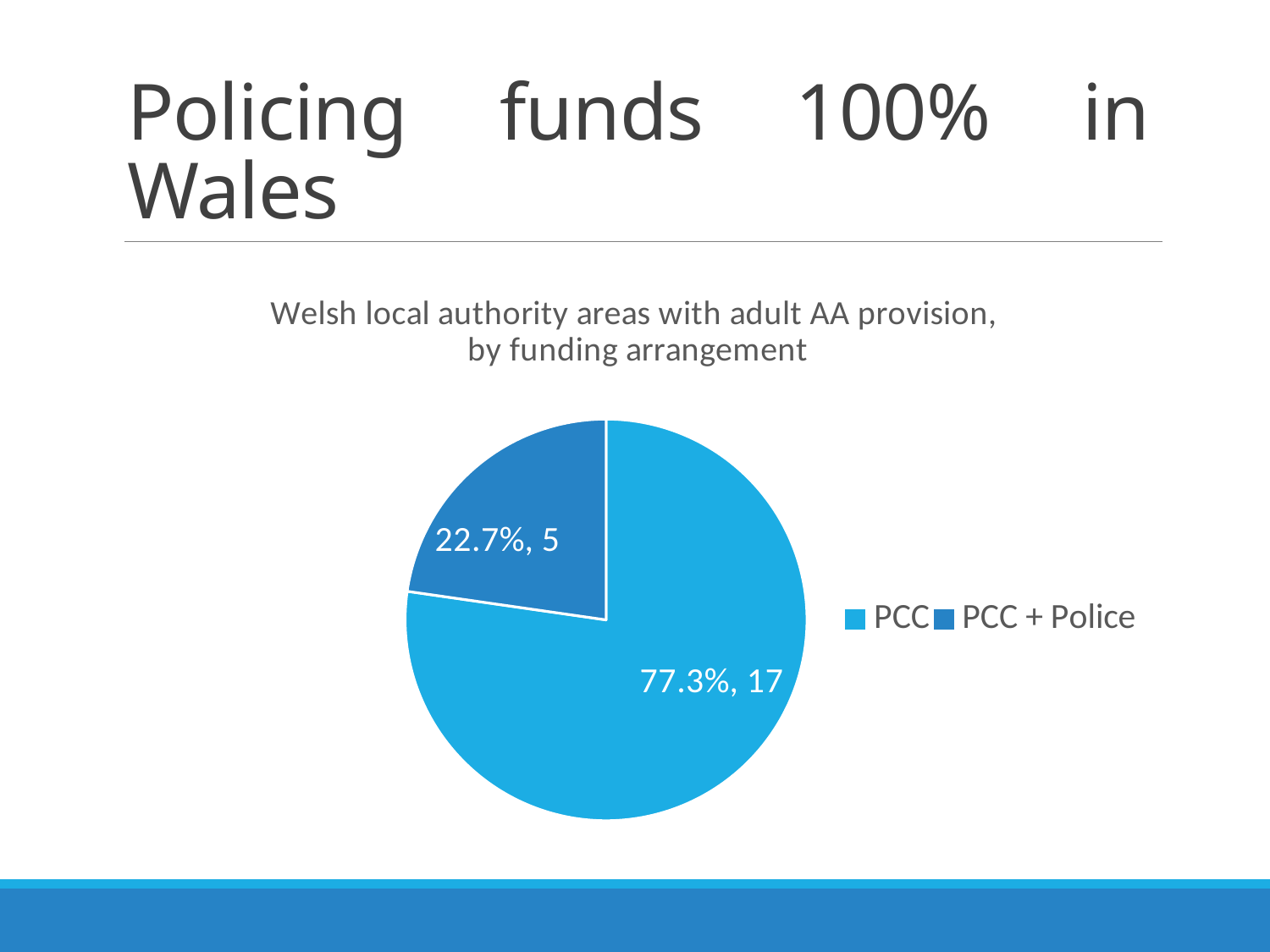
How many slices does the pie chart have? 2 How many local authority areas are in the PCC + Police category? 5 How many local authority areas are in the PCC category? 17 What is the total number of local authority areas shown across both slices? 22 What is the title of the chart? Welsh local authority areas with adult AA provision, by funding arrangement What share of the pie does the PCC slice represent? 77.3% What is the difference in the number of areas between PCC and PCC + Police? 12 Which funding arrangement has the largest slice? PCC How many entries does the legend list? 2 What share of the pie does the PCC + Police slice represent? 22.7% What kind of chart is shown on the slide? Pie chart Which funding arrangement has the smallest slice? PCC + Police